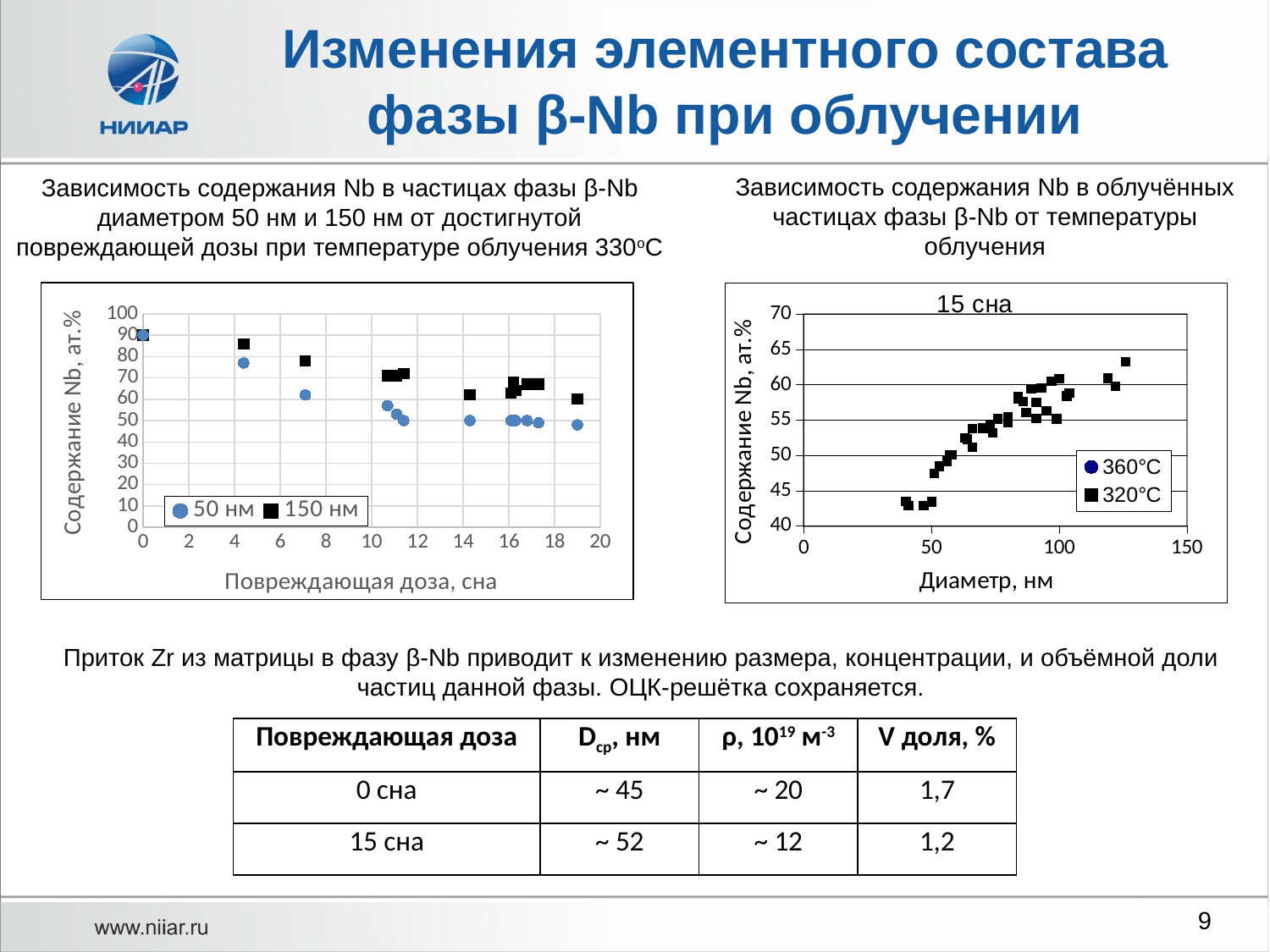
In the right chart titled "15 сна", is the Nb content at a diameter of about 40 нм greater or less than 45? less In the left chart, at a dose of about 4.5 сна, which series has the higher Nb content: 50 нм or 150 нм? 150 нм In the left chart, is the 150 нм value at a dose of about 4.5 сна greater or less than 80? greater What is the x-axis title of the right chart titled "15 сна"? Диаметр, нм What kind of chart is the right chart titled "15 сна"? scatter chart What kind of chart is the left chart (Nb content vs damaging dose)? scatter chart In the left chart, do the Nb content values rise or fall as the damaging dose increases? fall In the right chart titled "15 сна", does the Nb content rise or fall as the diameter increases? rise What are the two legend entries of the right chart titled "15 сна"? 360°C and 320°C How many series does the legend of the left chart list? 2 In the left chart, is the 50 нм value at a dose of about 7 сна greater or less than 70? less How many series does the legend of the right chart titled "15 сна" list? 2